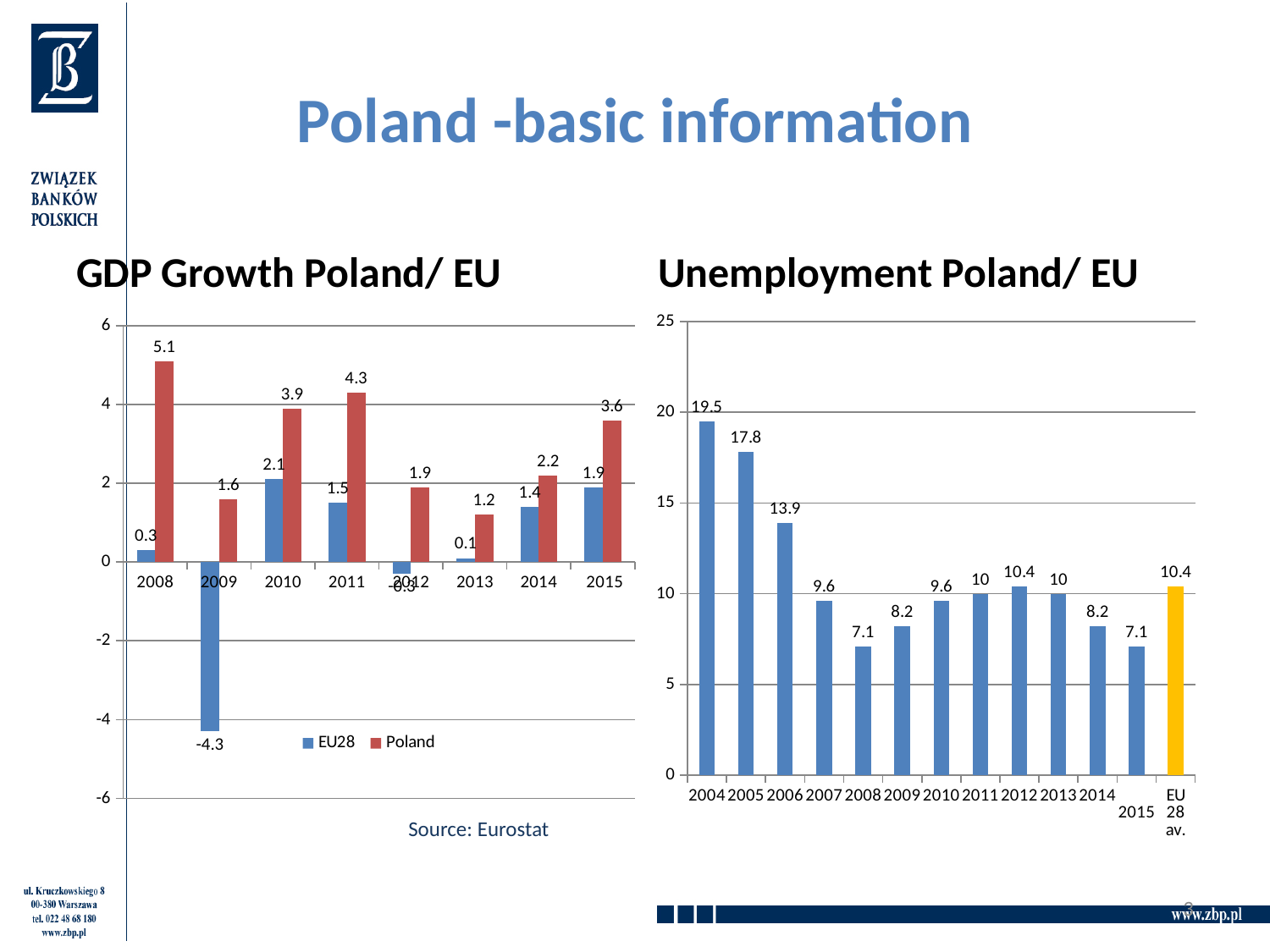
In the GDP Growth Poland/ EU chart, what is the value for EU28 in 2009? -4.3 In the GDP Growth Poland/ EU chart, in which year is the EU28 value lowest? 2009 In the GDP Growth Poland/ EU chart, in which year is the Poland value highest? 2008 In the GDP Growth Poland/ EU chart, what is the difference between the Poland and EU28 values in 2011? 2.8 In the Unemployment Poland/ EU chart, what is the value for 2004? 19.5 How many series does the legend of the GDP Growth Poland/ EU chart list? 2 What kind of chart is the Unemployment Poland/ EU chart? Bar chart In the Unemployment Poland/ EU chart, do the values rise or fall from 2004 to 2008? Fall In the GDP Growth Poland/ EU chart, what is the value for Poland in 2008? 5.1 In the Unemployment Poland/ EU chart, which is larger: the value for 2015 or the value for EU 28 av.? EU 28 av. In the Unemployment Poland/ EU chart, which year has the highest value? 2004 In the Unemployment Poland/ EU chart, what is the value for EU 28 av.? 10.4